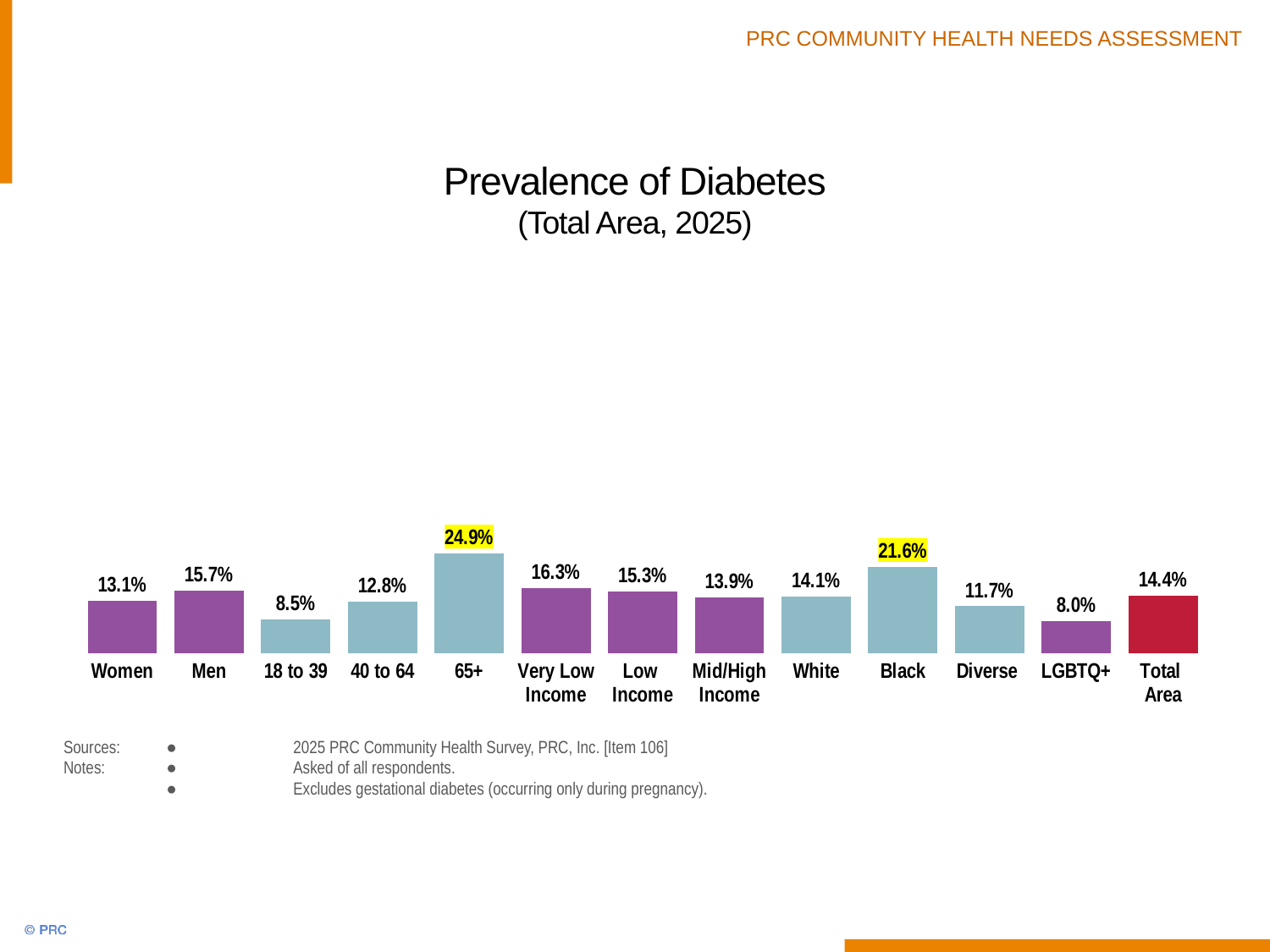
What is the difference in diabetes prevalence between Black and White respondents? 7.5% What is the prevalence of diabetes for LGBTQ+ respondents? 8.0% What is the prevalence of diabetes for Women? 13.1% What is the title of the chart? Prevalence of Diabetes (Total Area, 2025) Which has a higher prevalence of diabetes, Very Low Income or Mid/High Income? Very Low Income What is the difference in diabetes prevalence between Men and Women? 2.6% What type of chart is shown on the slide? Bar chart What is the prevalence of diabetes for the Total Area? 14.4% Which category has the lowest prevalence of diabetes? LGBTQ+ Which category has the highest prevalence of diabetes? 65+ What is the prevalence of diabetes for the 65+ age group? 24.9% How many categories are shown in the chart? 13